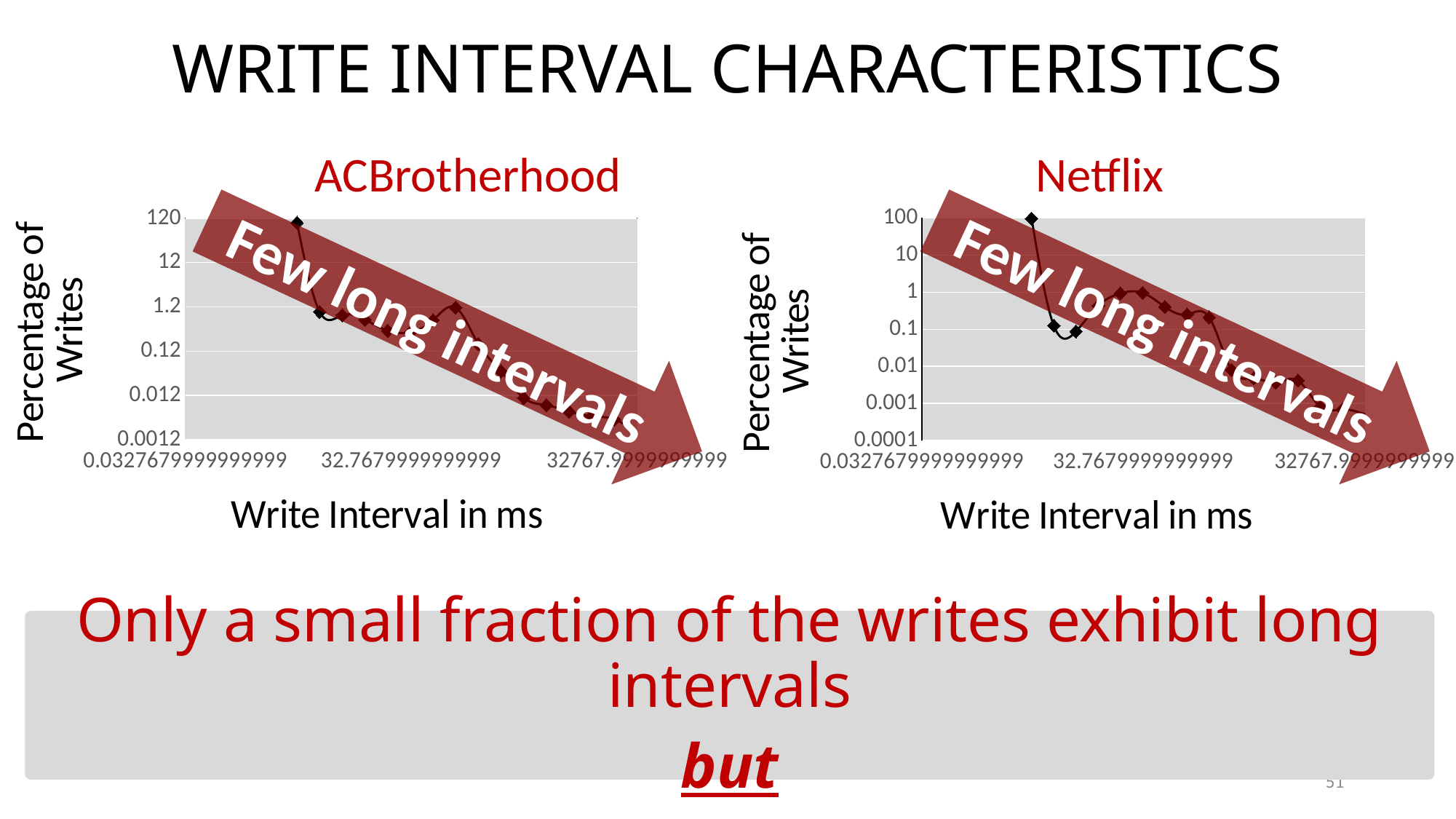
What is the x-axis label of the Netflix chart? Write Interval in ms In the Netflix chart, which is larger: the value at the leftmost point or the value at the rightmost point? the leftmost point In the Netflix chart, is the value of the rightmost plotted point greater or less than 0.01? less In the Netflix chart, do the values generally rise or fall as the write interval increases along the x axis? fall In the ACBrotherhood chart, is the value of the first (leftmost) plotted point greater or less than 12? greater What type of chart is the Netflix chart? line chart What is the y-axis label of the ACBrotherhood chart? Percentage of Writes In the ACBrotherhood chart, is the value of the rightmost plotted point greater or less than 0.12? less In the ACBrotherhood chart, which is larger: the value at the leftmost point or the value at the rightmost point? the leftmost point In the ACBrotherhood chart, do the values generally rise or fall as the write interval increases along the x axis? fall What type of chart is the ACBrotherhood chart? line chart